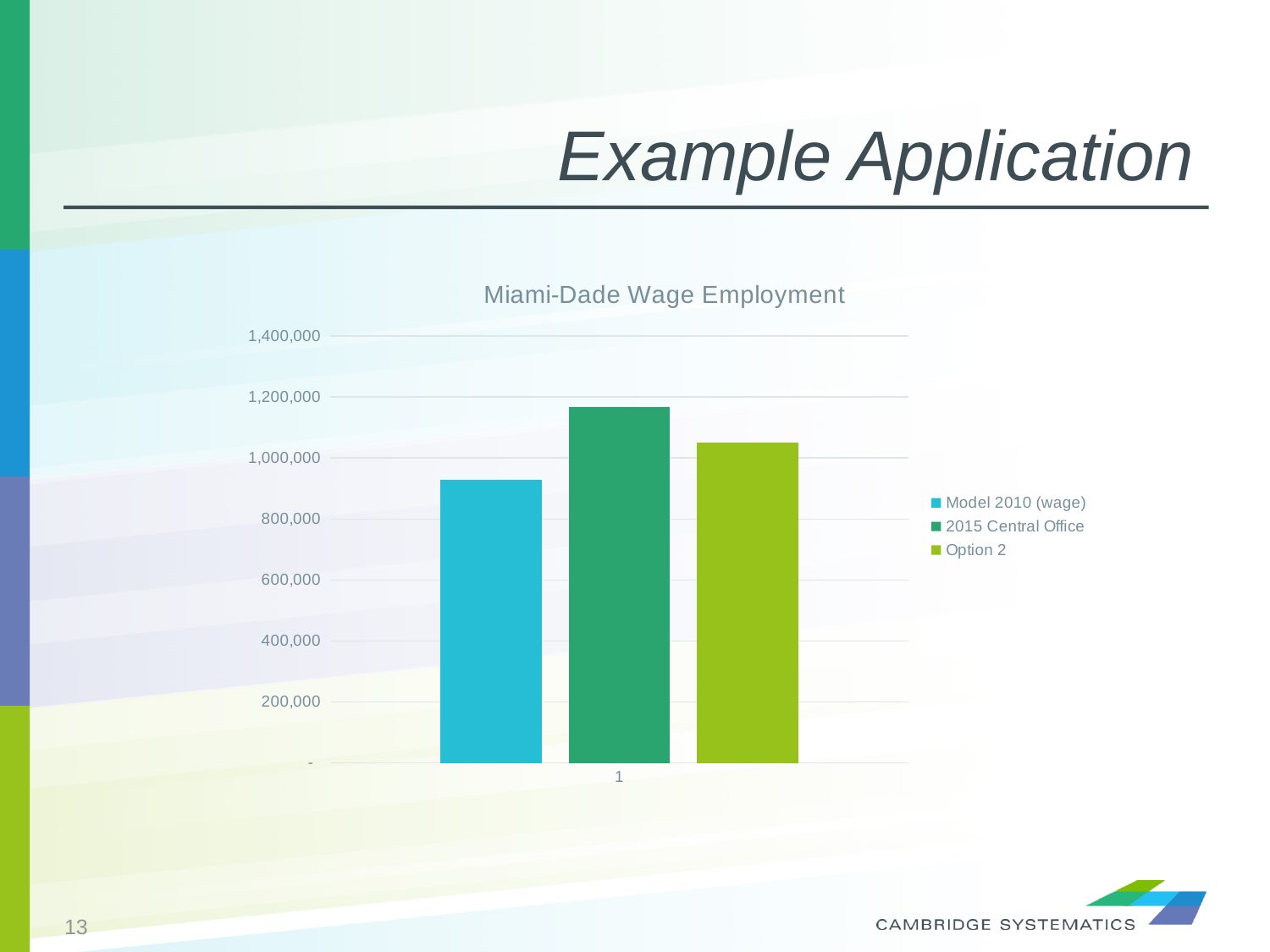
What kind of chart is shown on the slide? Bar chart Is the value for Model 2010 (wage) greater or less than 1,000,000? less What is the highest value shown on the vertical axis? 1,400,000 How many series does the legend list? 3 What is the title of the chart? Miami-Dade Wage Employment Is the value for Model 2010 (wage) greater or less than 800,000? greater Which series has the highest bar? 2015 Central Office Is the value for Option 2 greater or less than 1,200,000? less Which is larger, the value for 2015 Central Office or the value for Option 2? 2015 Central Office Which is larger, the value for Option 2 or the value for Model 2010 (wage)? Option 2 Which series has the lowest bar? Model 2010 (wage)